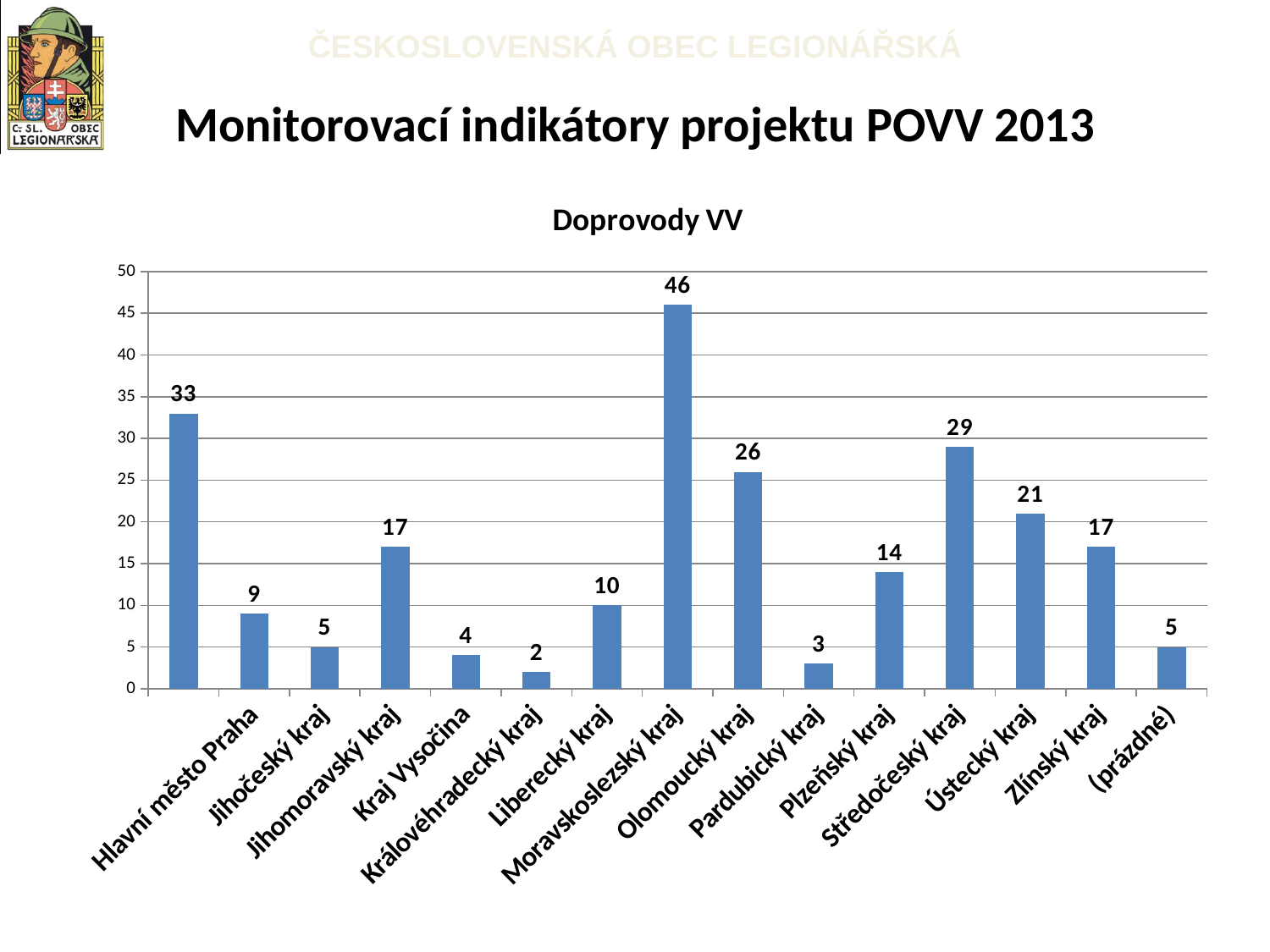
Is the value for Olomoucký kraj greater or less than 20? greater What is the value for Jihočeský kraj? 5 Which category has the highest value? Moravskoslezský kraj What kind of chart is shown? bar chart What is the value for Moravskoslezský kraj? 46 Which category has the lowest value? Královéhradecký kraj Which is larger, the value for Ústecký kraj or the value for Zlínský kraj? Ústecký kraj What is the value for Hlavní město Praha? 9 What is the difference between the values for Středočeský kraj and Olomoucký kraj? 3 What is the value for Plzeňský kraj? 14 What is the title of the chart? Doprovody VV